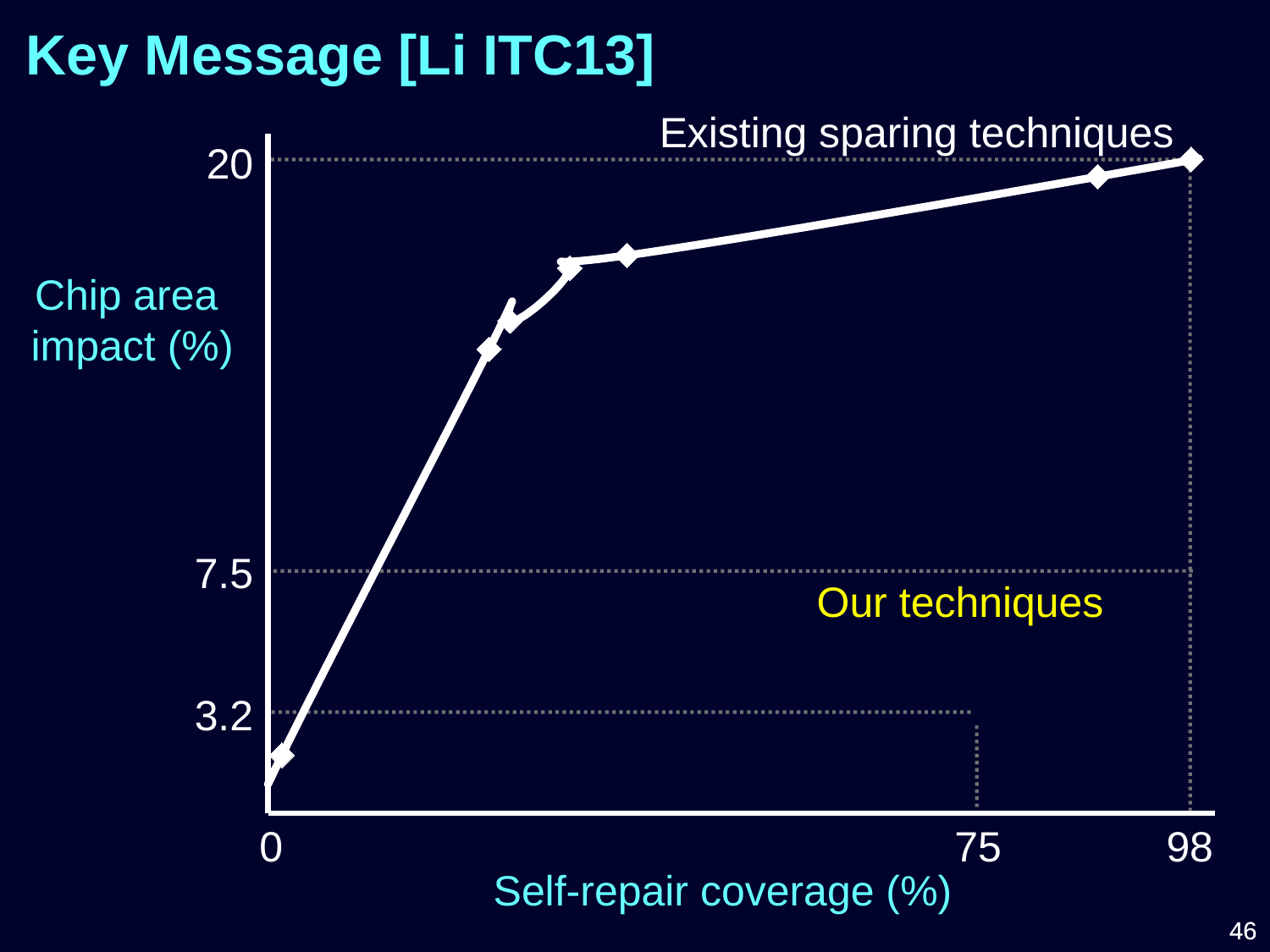
What is the highest self-repair coverage value labelled on the x axis? 98 What is the label of the x axis? Self-repair coverage (%) What is the label of the y axis? Chip area impact (%) What is the highest value labelled on the y axis? 20 Which is larger: the chip area impact at 98% coverage or at 0% coverage? 98% coverage Is the chip area impact of the plotted line at 0% self-repair coverage greater or less than 3.2? less What chip area impact (%) do existing sparing techniques reach at 98% self-repair coverage? 20 Is the chip area impact of the plotted line at 75% self-repair coverage greater or less than 7.5? greater How many tick values are labelled on the x axis? 3 How many tick values are labelled on the y axis? 3 What kind of chart is shown on the slide? line chart Does the chip area impact rise or fall as self-repair coverage increases along the x axis? rise